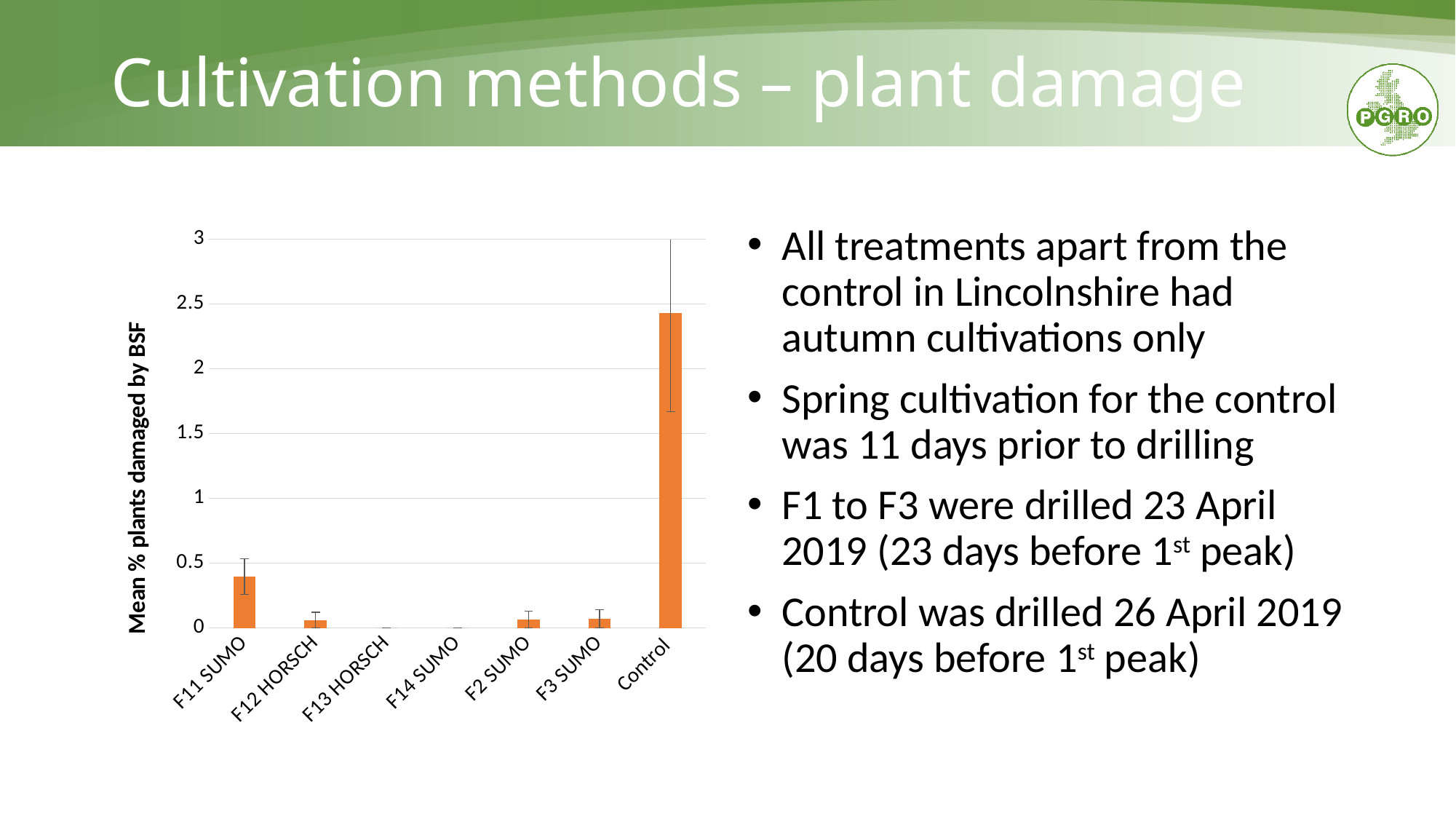
How many categories are plotted on the x axis of the chart? 7 Is the value for F12 HORSCH greater or less than 0.5? less Which has a larger value, F3 SUMO or Control? Control Which has a larger value, Control or F11 SUMO? Control Which category has the highest mean % plants damaged by BSF? Control Is the value for Control greater or less than 2? greater Which has a larger value, F11 SUMO or F12 HORSCH? F11 SUMO What kind of chart is shown on the slide? bar chart What is the label of the y axis of the chart? Mean % plants damaged by BSF What colour are the bars in the chart? orange Is the value for F11 SUMO greater or less than 0.5? less